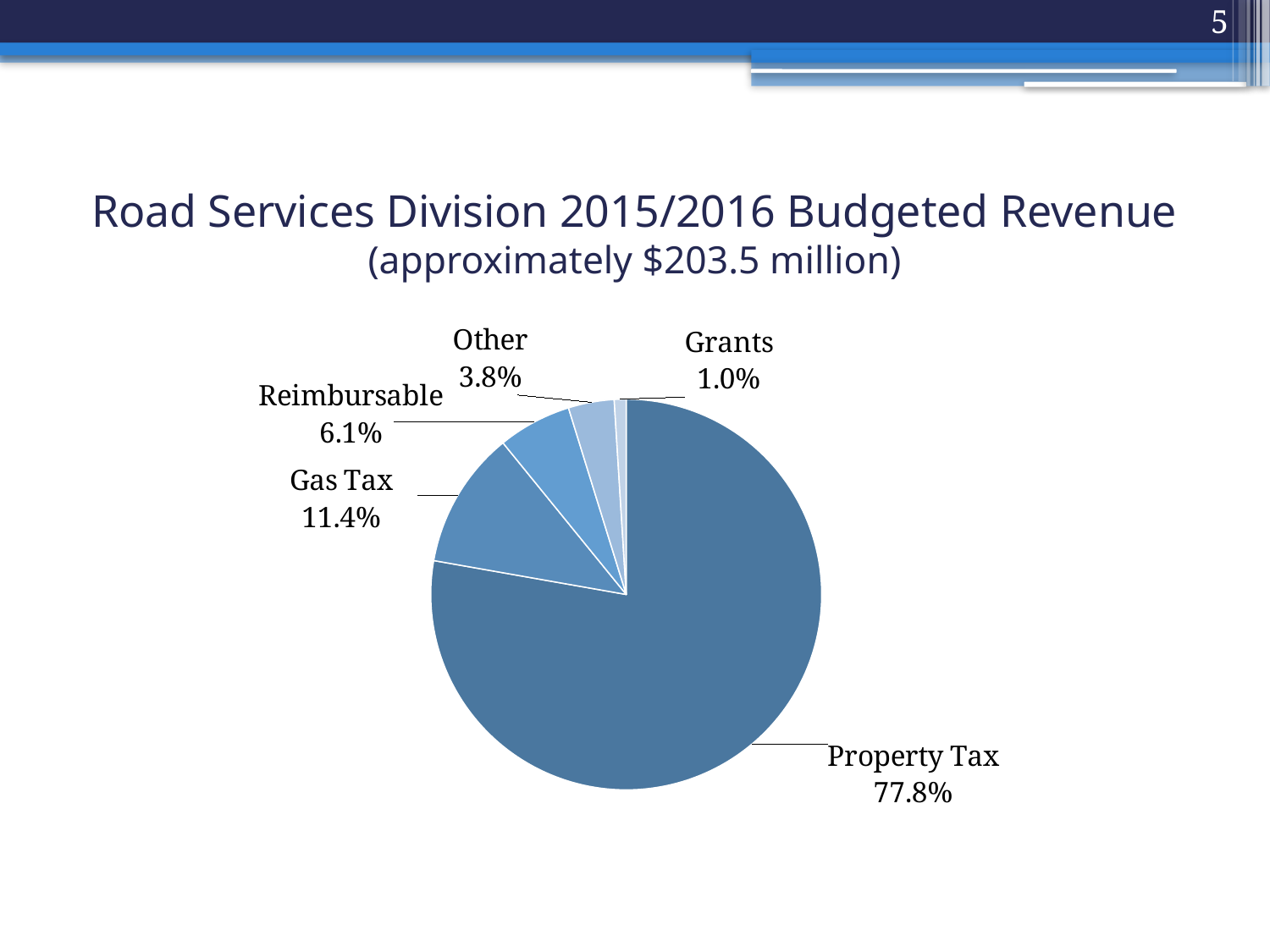
Which revenue source has the largest share of the pie? Property Tax What is the difference in percentage points between the Gas Tax share and the Reimbursable share? 5.3 What share of the budgeted revenue comes from Property Tax? 77.8% What approximate total revenue amount is stated in the chart title? $203.5 million What share of the budgeted revenue comes from Gas Tax? 11.4% What kind of chart is shown on the slide? pie chart What share of the budgeted revenue comes from Other? 3.8% How many slices does the pie chart have? 5 Which is larger, the share for Gas Tax or the share for Reimbursable? Gas Tax Which revenue source has the smallest share of the pie? Grants